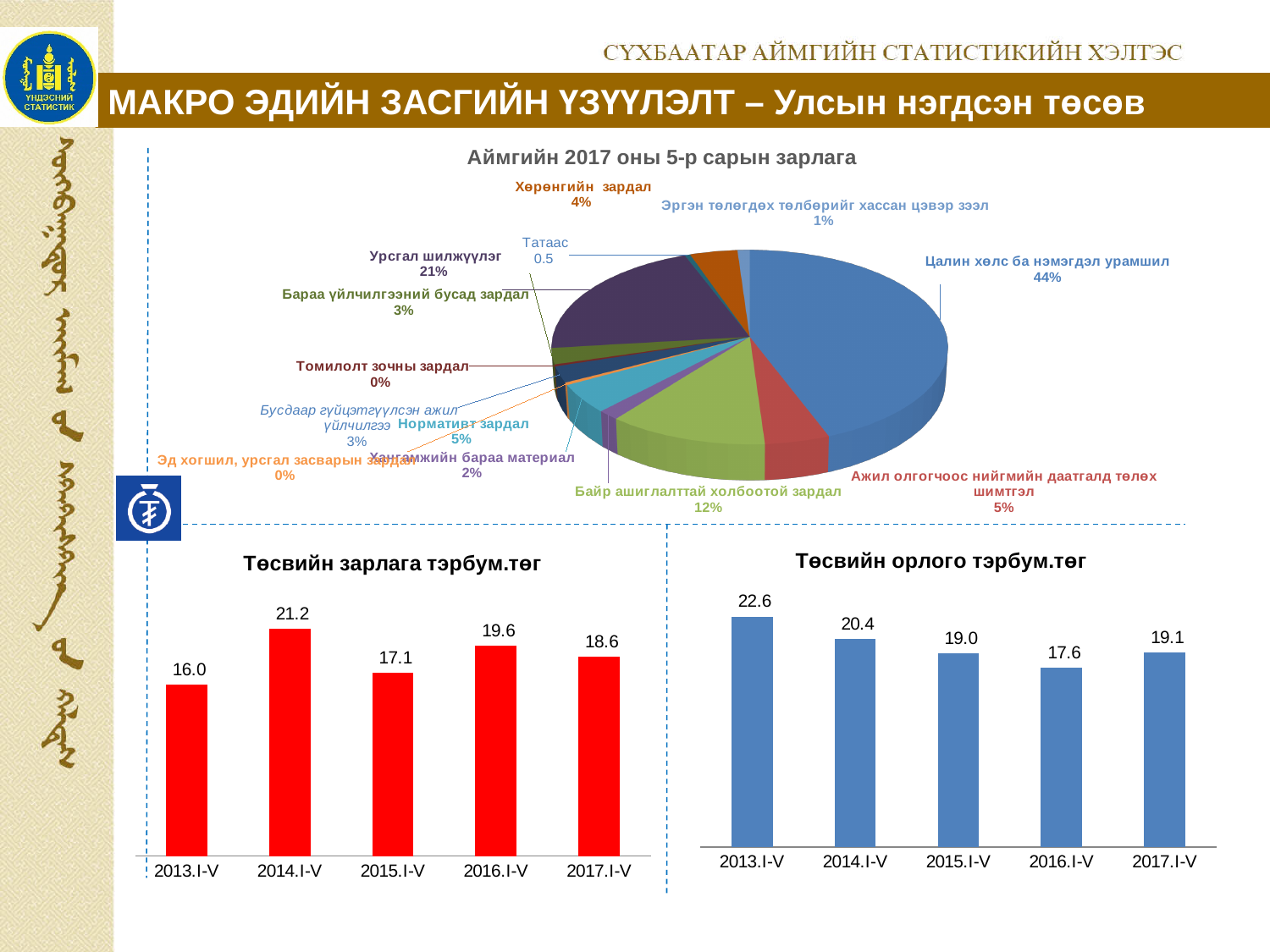
In the 'Аймгийн 2017 оны 5-р сарын зарлага' pie chart, what share does 'Урсгал шилжүүлэг' have? 21% In the 'Аймгийн 2017 оны 5-р сарын зарлага' pie chart, what share does 'Байр ашиглалттай холбоотой зардал' have? 12% In the 'Төсвийн зарлага тэрбум.төг' chart, what is the difference between the values for 2014.I-V and 2015.I-V? 4.1 In the 'Төсвийн зарлага тэрбум.төг' chart, what is the value for 2014.I-V? 21.2 In the 'Төсвийн зарлага тэрбум.төг' chart, which period has the lowest value? 2013.I-V In the 'Төсвийн орлого тэрбум.төг' chart, what is the value for 2016.I-V? 17.6 What kind of chart is 'Төсвийн зарлага тэрбум.төг'? Bar chart In the 'Төсвийн орлого тэрбум.төг' chart, how many periods are shown? 5 In the 'Төсвийн орлого тэрбум.төг' chart, which is larger: the value for 2014.I-V or 2017.I-V? 2014.I-V What kind of chart is 'Аймгийн 2017 оны 5-р сарын зарлага'? Pie chart In the 'Аймгийн 2017 оны 5-р сарын зарлага' pie chart, what share does 'Цалин хөлс ба нэмэгдэл урамшил' have? 44% In the 'Төсвийн орлого тэрбум.төг' chart, which period has the highest value? 2013.I-V